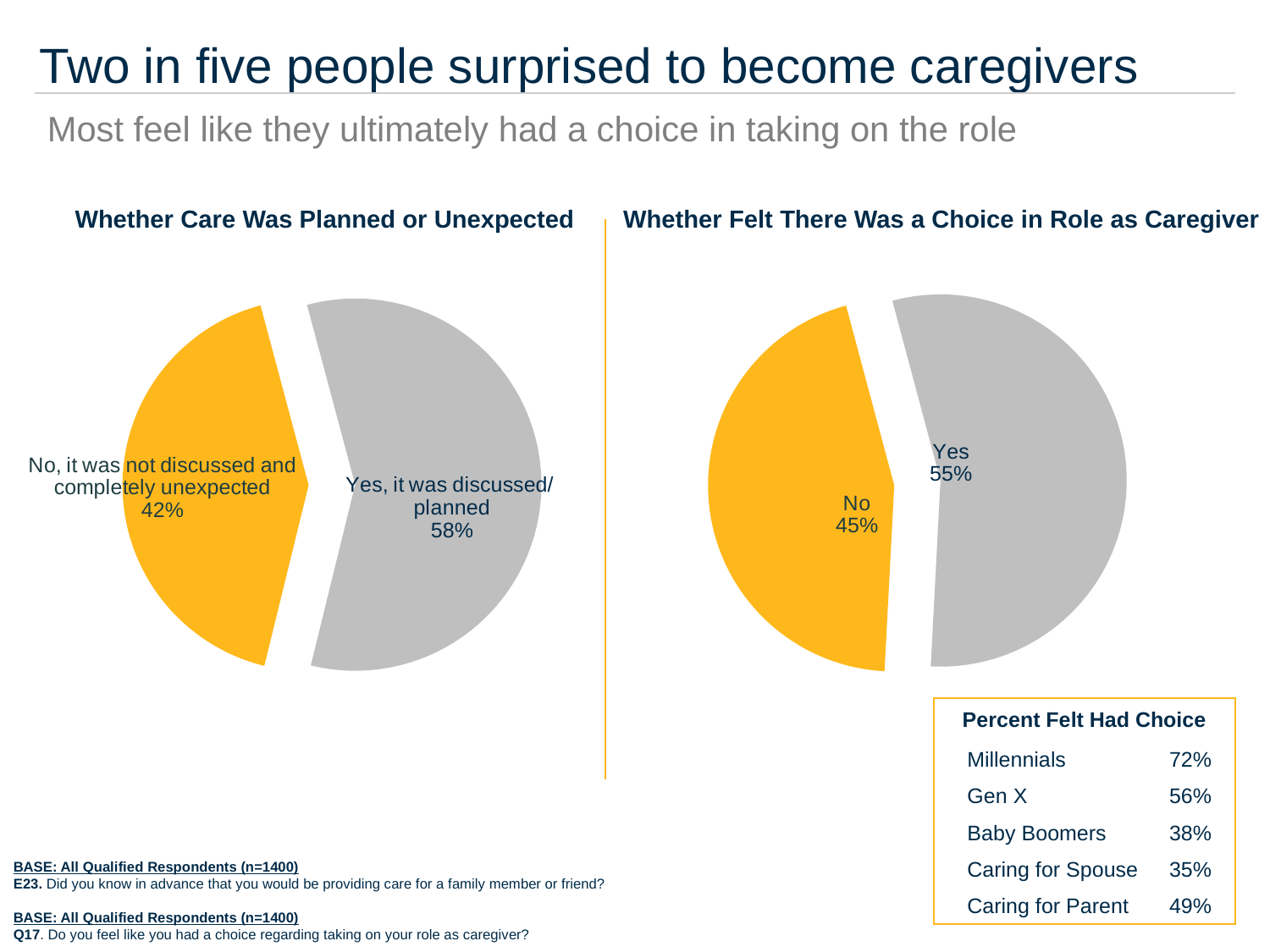
What kind of chart is 'Whether Care Was Planned or Unexpected'? Pie chart In the 'Whether Felt There Was a Choice in Role as Caregiver' chart, what colour is the 'No' slice? Yellow In the 'Whether Felt There Was a Choice in Role as Caregiver' chart, which slice is the smallest? No In the 'Whether Care Was Planned or Unexpected' chart, which is larger: the 'Yes, it was discussed/planned' slice or the 'No, it was not discussed and completely unexpected' slice? Yes, it was discussed/planned In the 'Whether Care Was Planned or Unexpected' chart, what percentage said 'Yes, it was discussed/planned'? 58% In the 'Whether Care Was Planned or Unexpected' chart, what is the difference in percentage points between the 'Yes' and 'No' slices? 16 In the 'Whether Care Was Planned or Unexpected' chart, which slice is the largest? Yes, it was discussed/planned In the 'Whether Felt There Was a Choice in Role as Caregiver' chart, what is the difference in percentage points between 'Yes' and 'No'? 10 In the 'Whether Care Was Planned or Unexpected' chart, what percentage said 'No, it was not discussed and completely unexpected'? 42% How many slices does the 'Whether Felt There Was a Choice in Role as Caregiver' pie chart have? 2 In the 'Whether Felt There Was a Choice in Role as Caregiver' chart, what percentage answered 'No'? 45% In the 'Whether Felt There Was a Choice in Role as Caregiver' chart, what percentage answered 'Yes'? 55%